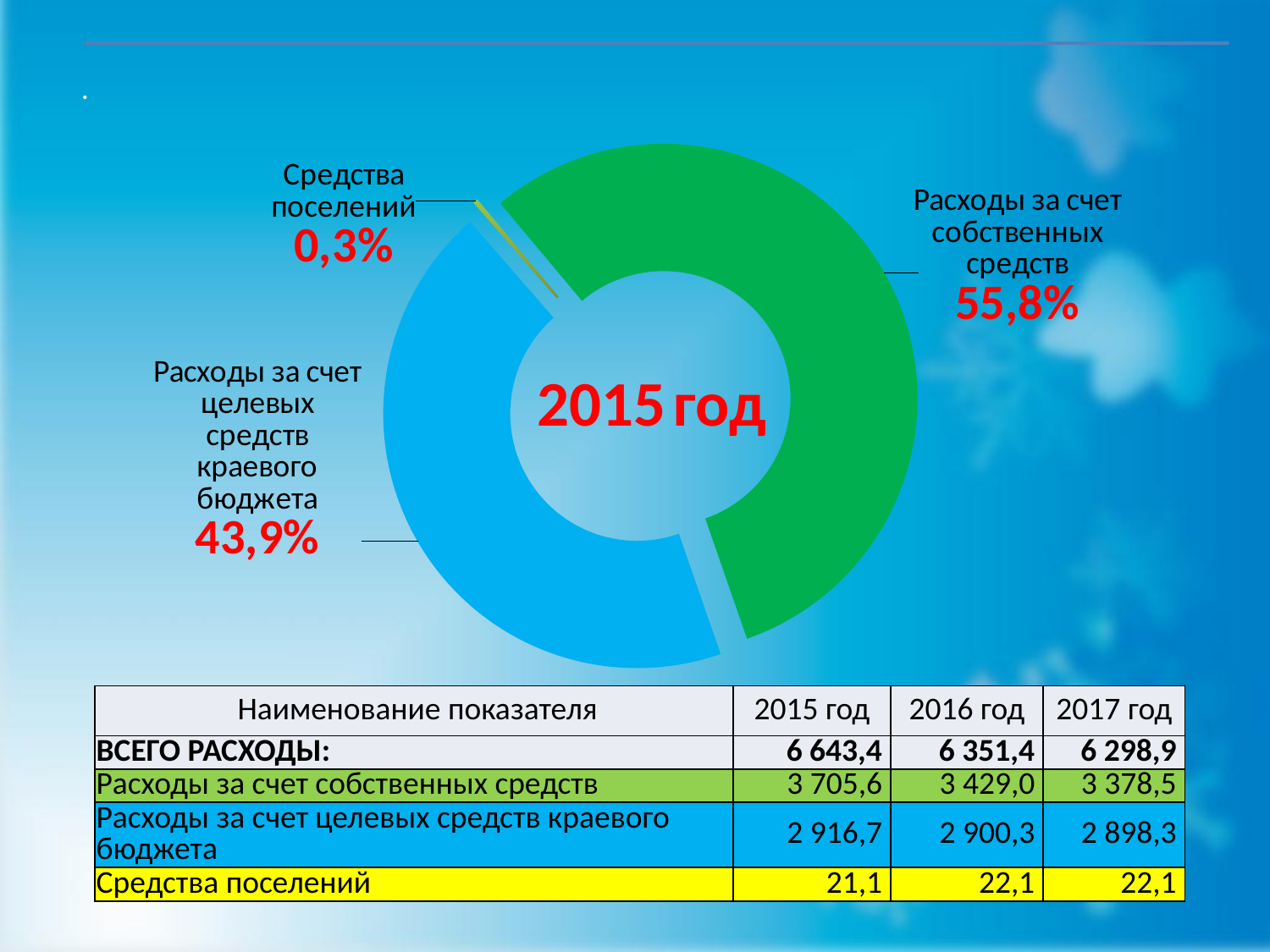
Is the share for "Расходы за счет целевых средств краевого бюджета" greater or less than 50%? less Which is larger in the doughnut chart: the share for "Расходы за счет целевых средств краевого бюджета" or the share for "Средства поселений"? Расходы за счет целевых средств краевого бюджета By how many percentage points does the share for "Расходы за счет собственных средств" exceed the share for "Расходы за счет целевых средств краевого бюджета"? 11,9 What share of the doughnut chart is labelled "Средства поселений"? 0,3% What share of the doughnut chart is labelled "Расходы за счет целевых средств краевого бюджета"? 43,9% Which slice of the doughnut chart is the smallest? Средства поселений What share of the doughnut chart is labelled "Расходы за счет собственных средств"? 55,8% What kind of chart is shown on the slide? Doughnut (pie) chart What colour is the slice for "Расходы за счет собственных средств" in the doughnut chart? Green Which slice of the doughnut chart is the largest? Расходы за счет собственных средств What year is written in the centre of the doughnut chart? 2015 год How many slices does the doughnut chart have? 3